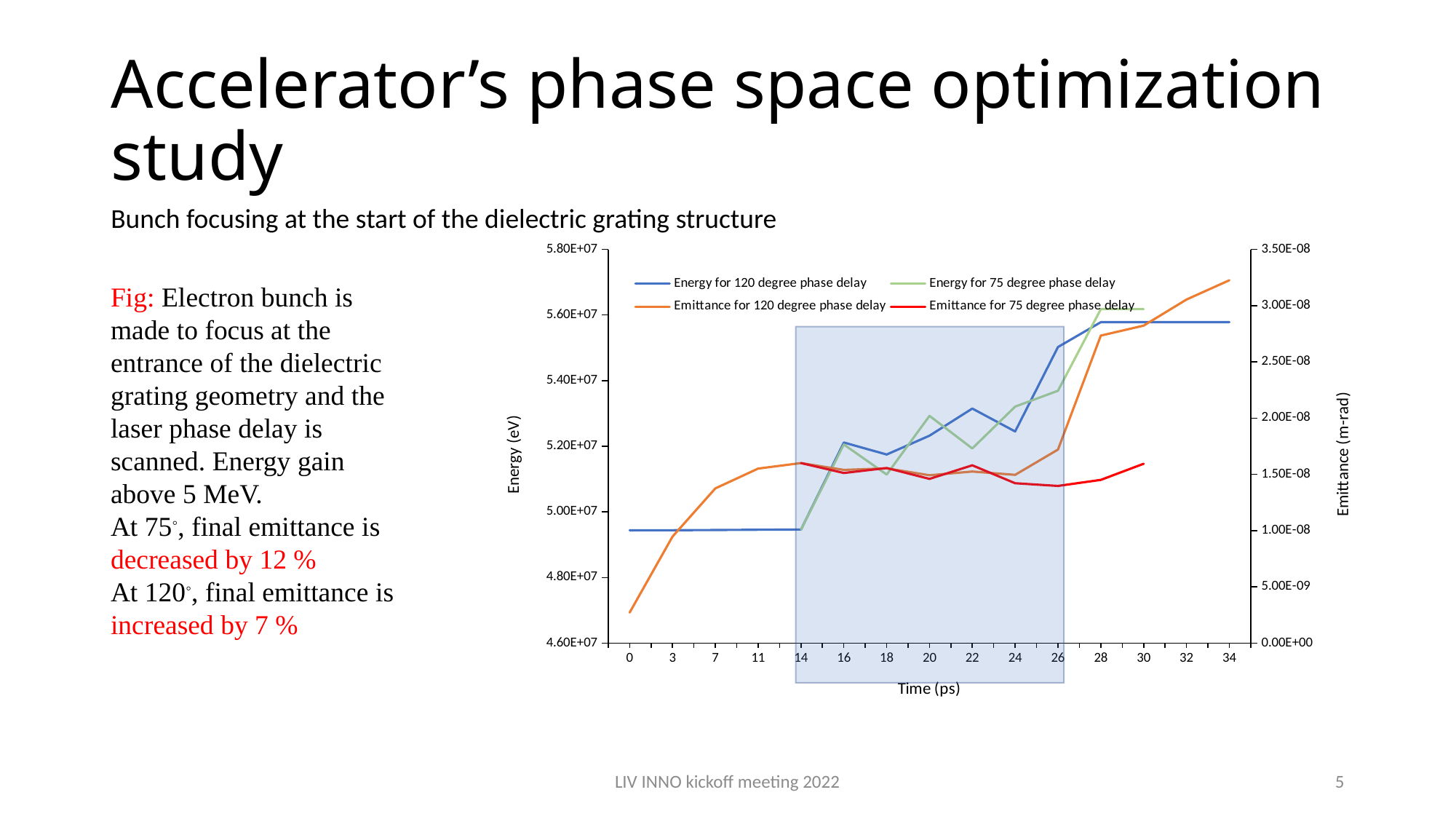
Is the value of Energy for 120 degree phase delay at time 0 greater or less than 5.00E+07? less Is the value of Energy for 120 degree phase delay at time 34 greater or less than 5.40E+07? greater Is the value of Emittance for 120 degree phase delay at time 0 greater or less than 5.00E-09? less How many time points are labelled on the x axis of the chart? 15 Does the Emittance for 120 degree phase delay series generally rise or fall as time increases? rise What is the label of the x axis of the chart? Time (ps) At time 28, which series has the larger value: Emittance for 120 degree phase delay or Emittance for 75 degree phase delay? Emittance for 120 degree phase delay What kind of chart is shown on the slide? line chart How many series does the chart legend list? 4 What is the label of the right-hand y axis of the chart? Emittance (m-rad) At time 22, which series has the larger value: Energy for 120 degree phase delay or Energy for 75 degree phase delay? Energy for 120 degree phase delay